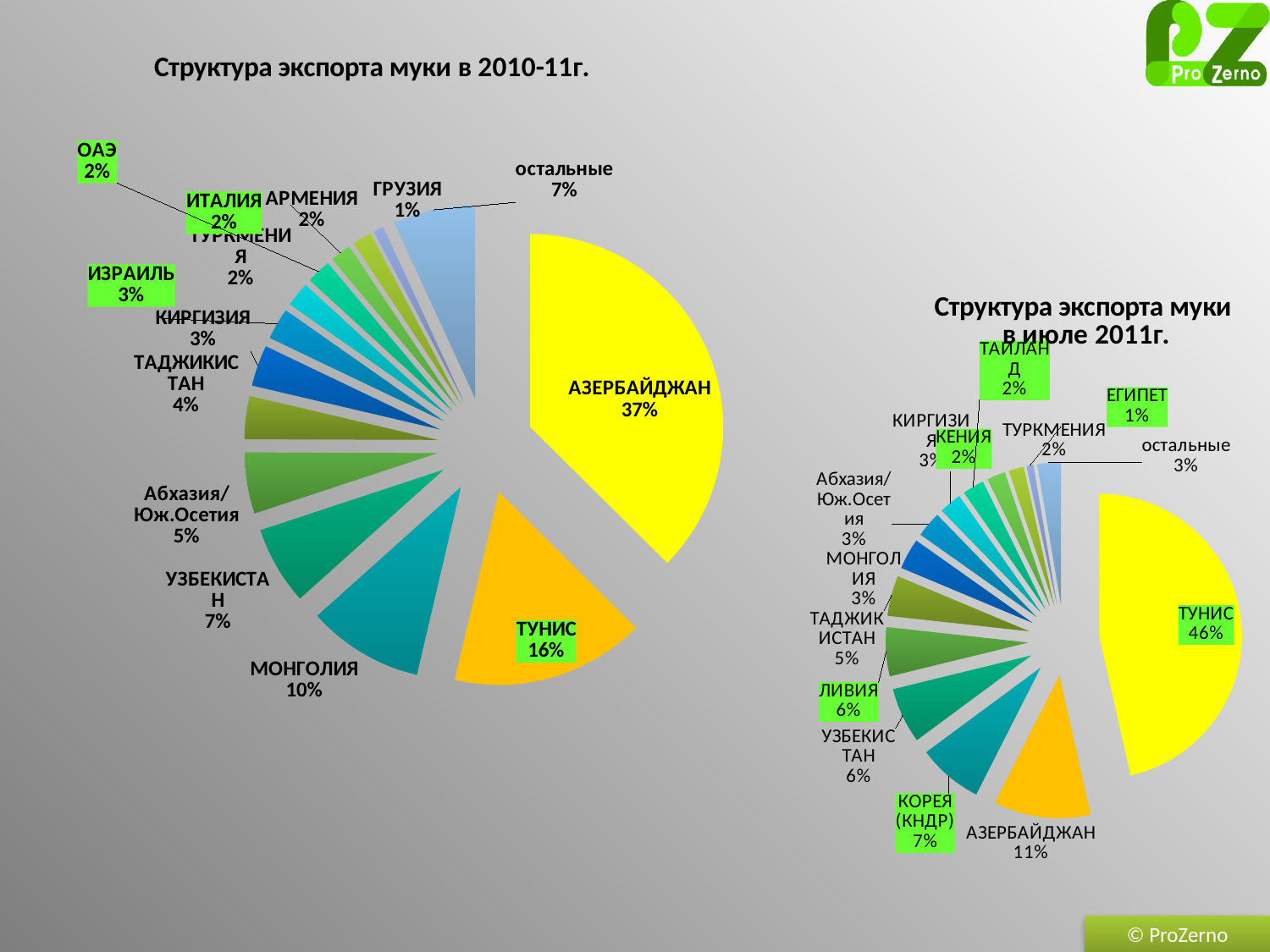
In the chart titled "Структура экспорта муки в июле 2011г.", what is the difference between the shares of ТУНИС and АЗЕРБАЙДЖАН? 35% In the chart titled "Структура экспорта муки в июле 2011г.", what share does ТУНИС have? 46% In the chart titled "Структура экспорта муки в 2010-11г.", which category has the smallest share? ГРУЗИЯ What type of chart is the chart titled "Структура экспорта муки в 2010-11г."? Pie chart In the chart titled "Структура экспорта муки в июле 2011г.", which is larger: ТАДЖИКИСТАН or МОНГОЛИЯ? ТАДЖИКИСТАН In the chart titled "Структура экспорта муки в июле 2011г.", what share does КОРЕЯ (КНДР) have? 7% In the chart titled "Структура экспорта муки в 2010-11г.", what share does АЗЕРБАЙДЖАН have? 37% In the chart titled "Структура экспорта муки в 2010-11г.", what share does ТУНИС have? 16% In the chart titled "Структура экспорта муки в 2010-11г.", which category has the largest share? АЗЕРБАЙДЖАН In the chart titled "Структура экспорта муки в июле 2011г.", which category has the largest share? ТУНИС In the chart titled "Структура экспорта муки в 2010-11г.", which is larger: МОНГОЛИЯ or УЗБЕКИСТАН? МОНГОЛИЯ In the chart titled "Структура экспорта муки в 2010-11г.", what is the difference between the shares of АЗЕРБАЙДЖАН and ТУНИС? 21%